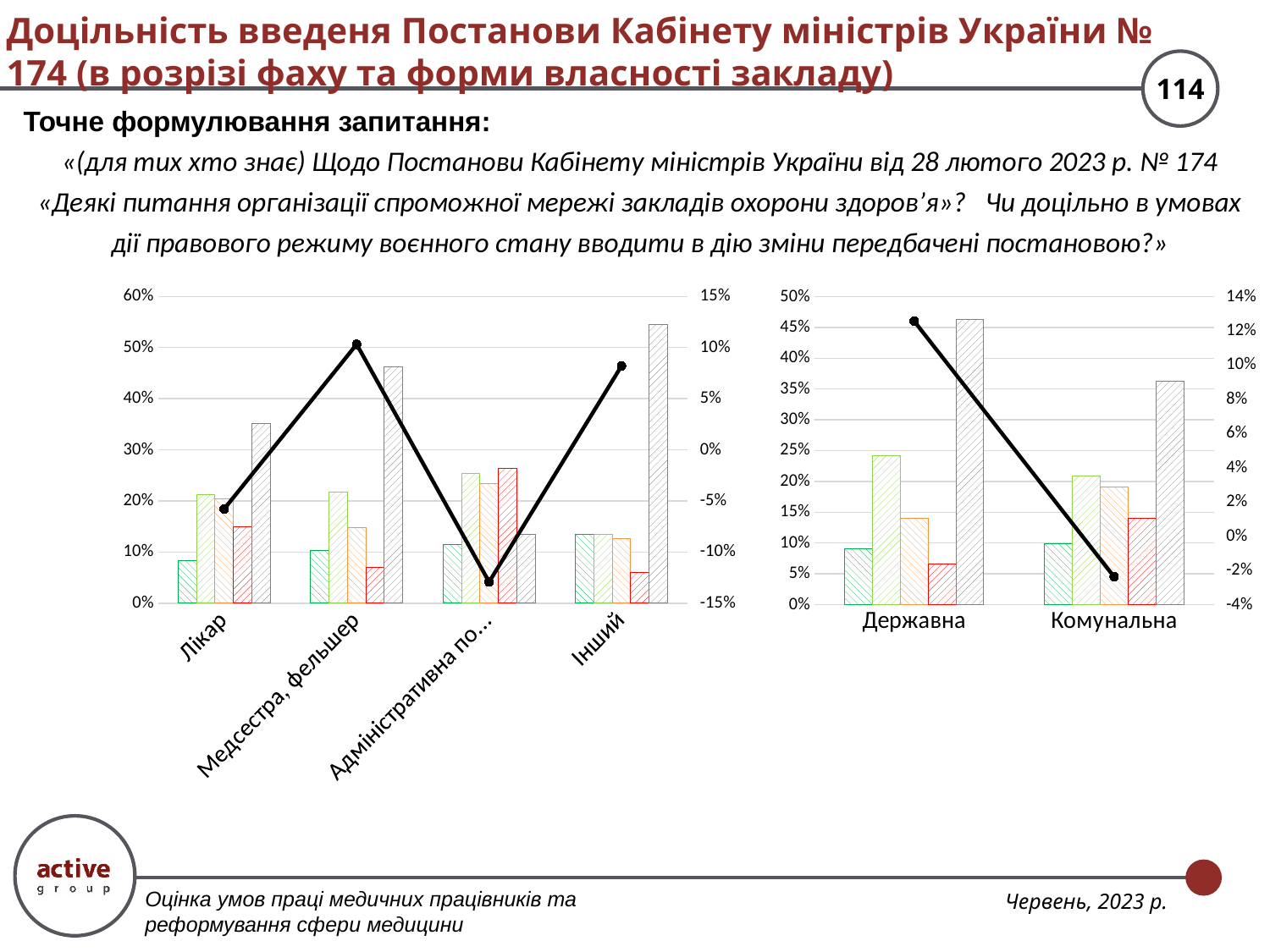
In the left chart, is the grey hatched bar for Інший greater or less than 50%? greater In the left chart, is the grey hatched bar for Лікар greater or less than 30%? greater How many categories are shown on the x axis of the right chart? 2 What kind of chart is the right chart? A combination bar and line chart In the right chart, does the black line rise or fall from Державна to Комунальна? Fall How many bars are plotted for each category in the right chart? 5 How many categories are shown on the x axis of the left chart? 4 In the right chart, is the grey hatched bar for Державна greater or less than 40%? greater In the left chart, which category has the tallest grey hatched bar? Інший In the right chart, which category has the larger grey hatched bar, Державна or Комунальна? Державна